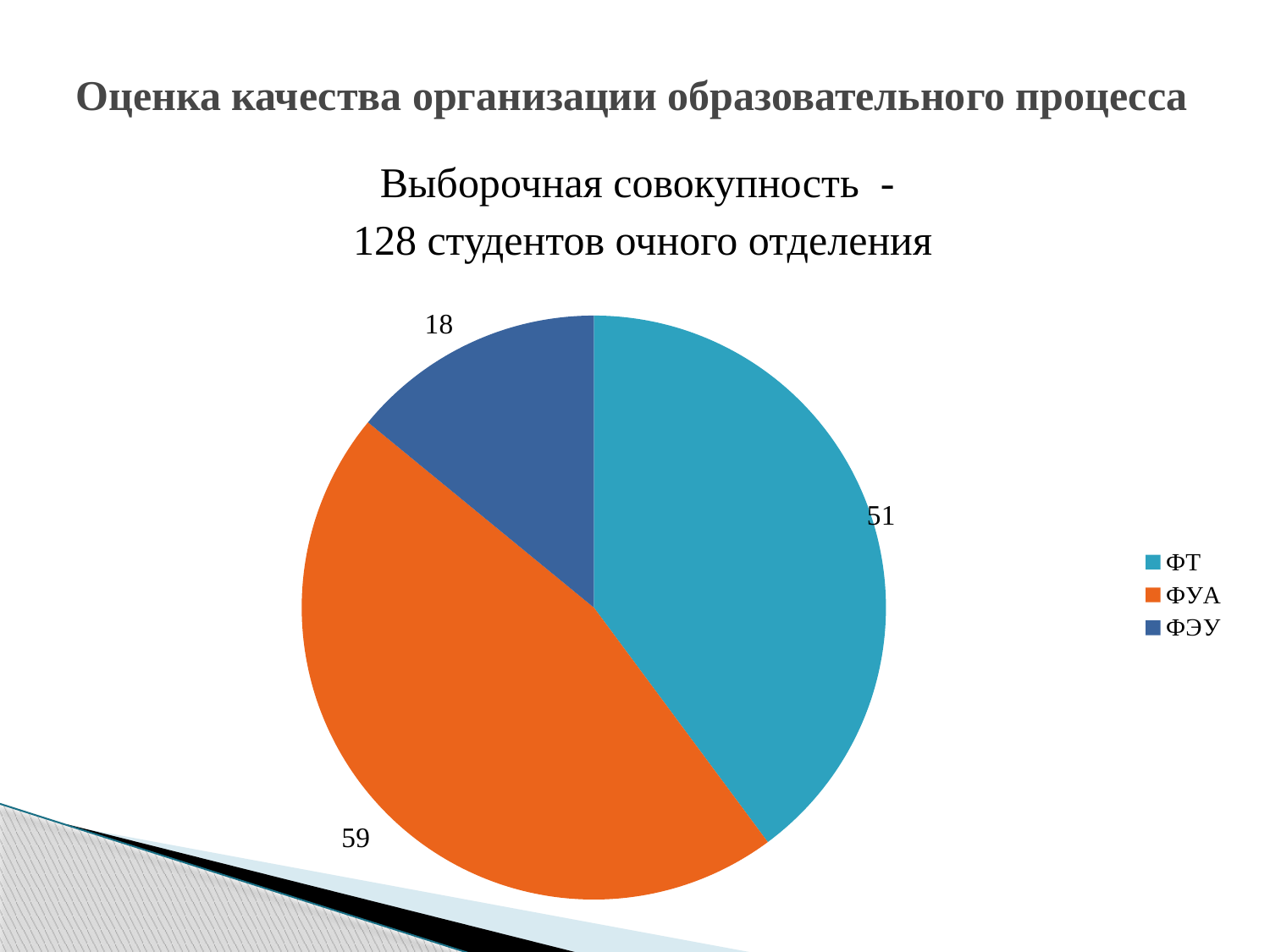
Which category has the smallest slice of the pie? ФЭУ Which is larger, the value for ФТ or the value for ФЭУ? ФТ What is the value for ФУА in the pie chart? 59 What is the difference between the values for ФУА and ФТ? 8 How many slices does the pie chart have? 3 What is the value for ФТ in the pie chart? 51 Which category has the largest slice of the pie? ФУА What is the difference between the values for ФТ and ФЭУ? 33 What kind of chart is shown on the slide? pie chart What is the total of all slices in the pie chart? 128 What is the value for ФЭУ in the pie chart? 18 What colour is the ФУА slice in the pie chart? orange